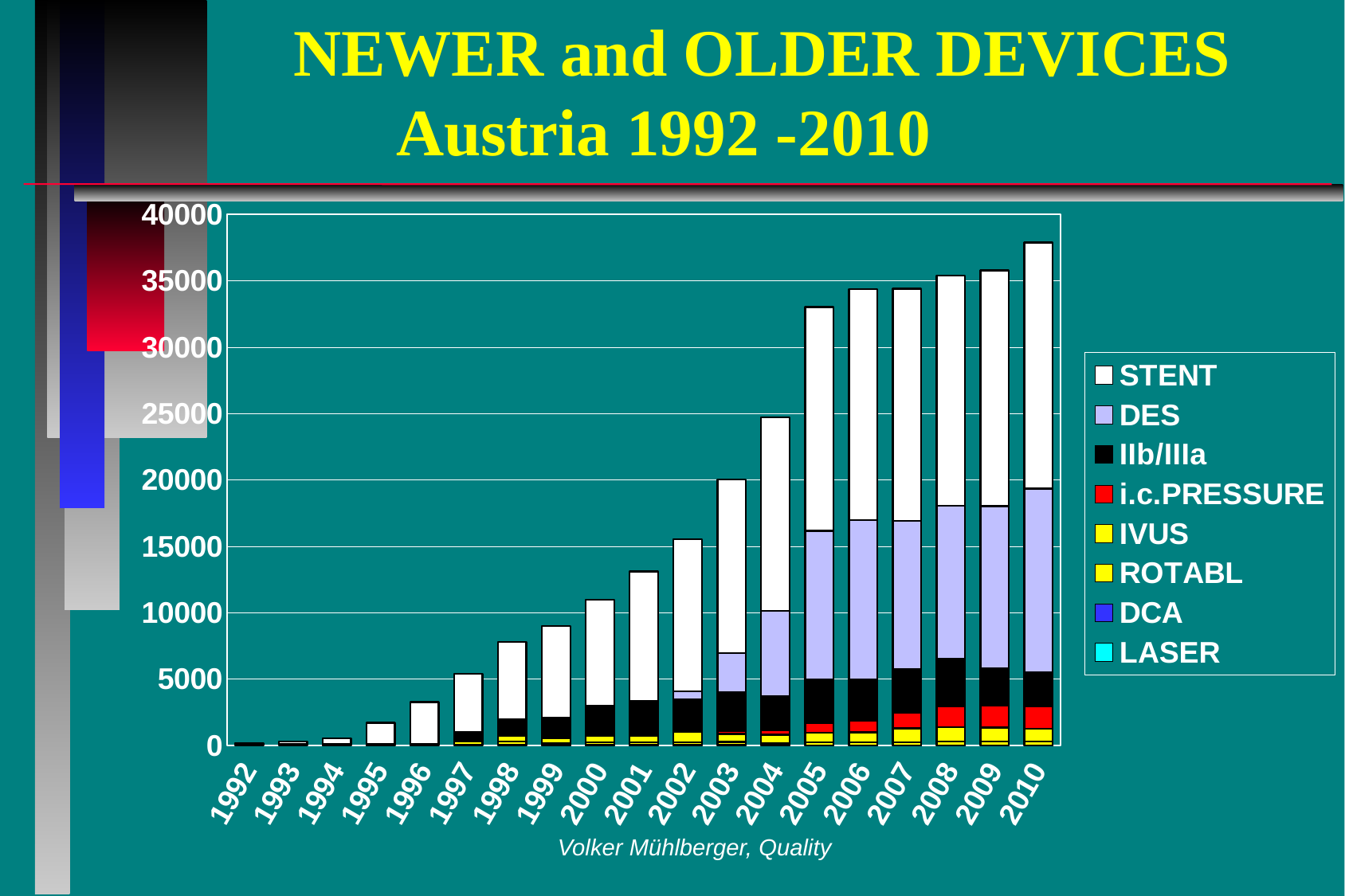
Which year has the tallest stacked bar? 2010 What kind of chart is shown on the slide? Stacked bar chart Is the total bar height for 2010 greater or less than 35000? greater Which year has the taller stacked bar, 2004 or 2005? 2005 Do the total bar heights generally rise or fall from 1992 to 2010? rise What is the title of the slide containing the chart? NEWER and OLDER DEVICES Austria 1992 -2010 How many years are shown along the x axis of the chart? 19 How many series does the chart's legend list? 8 Is the total bar height for 1999 greater or less than 10000? less Is the total bar height for 2001 greater or less than 15000? less Which year has the shortest stacked bar? 1992